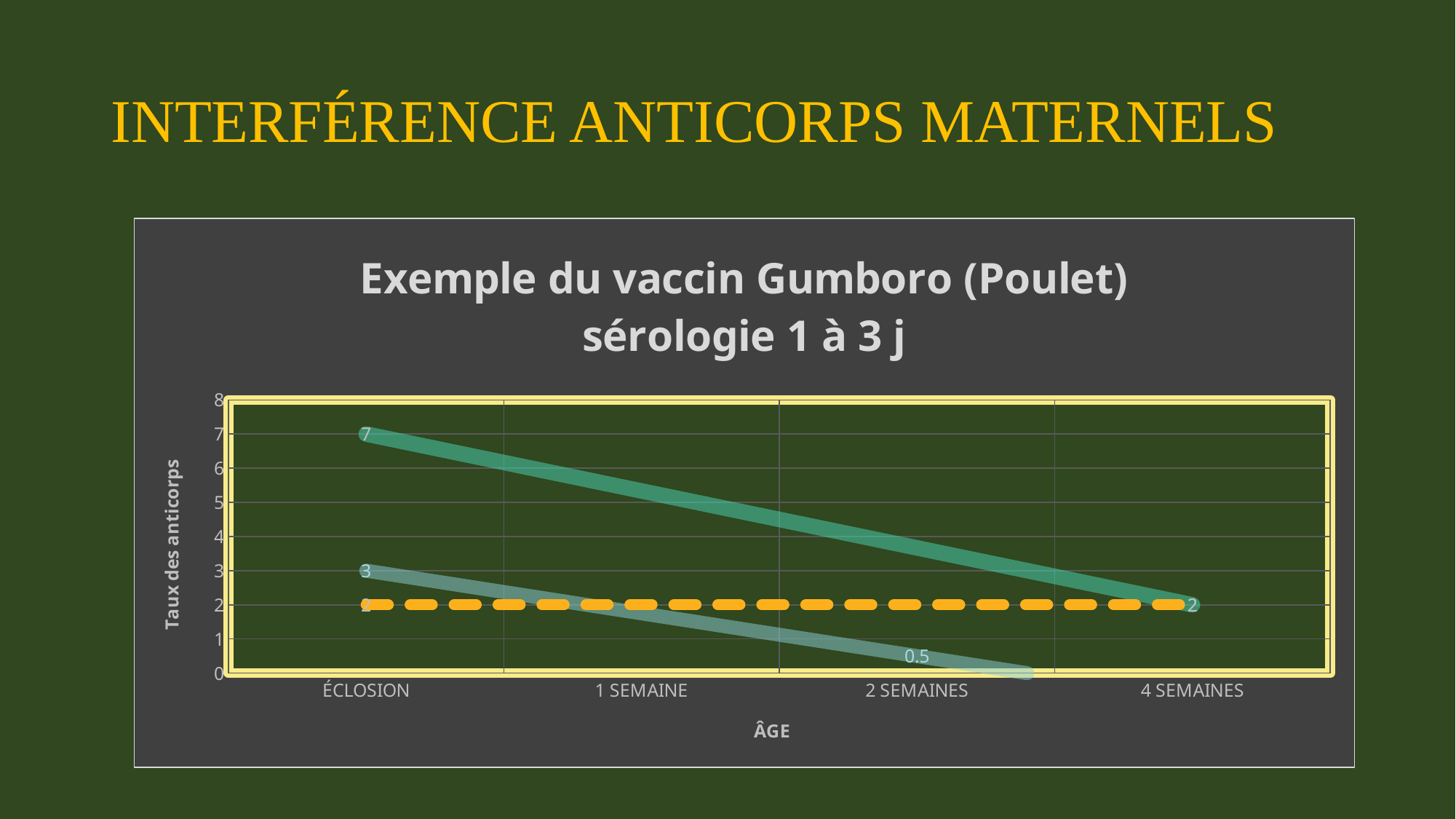
By how much does the dark green line fall between ÉCLOSION and 4 SEMAINES? 5 How many age categories are shown on the x axis? 4 What is the value of the dashed orange line at ÉCLOSION? 2 What value is labelled on the light green line at 2 SEMAINES? 0.5 What is the value of the light green line at ÉCLOSION? 3 What is the value of the dark green line at 4 SEMAINES? 2 Does the dark green line rise or fall from ÉCLOSION to 4 SEMAINES? fall What is the title of the chart? Exemple du vaccin Gumboro (Poulet) sérologie 1 à 3 j What is the label of the vertical axis? Taux des anticorps What kind of chart is shown on the slide? line chart Is the value of the dark green line at 1 SEMAINE greater or less than 4? greater What is the value of the dark green line at ÉCLOSION? 7